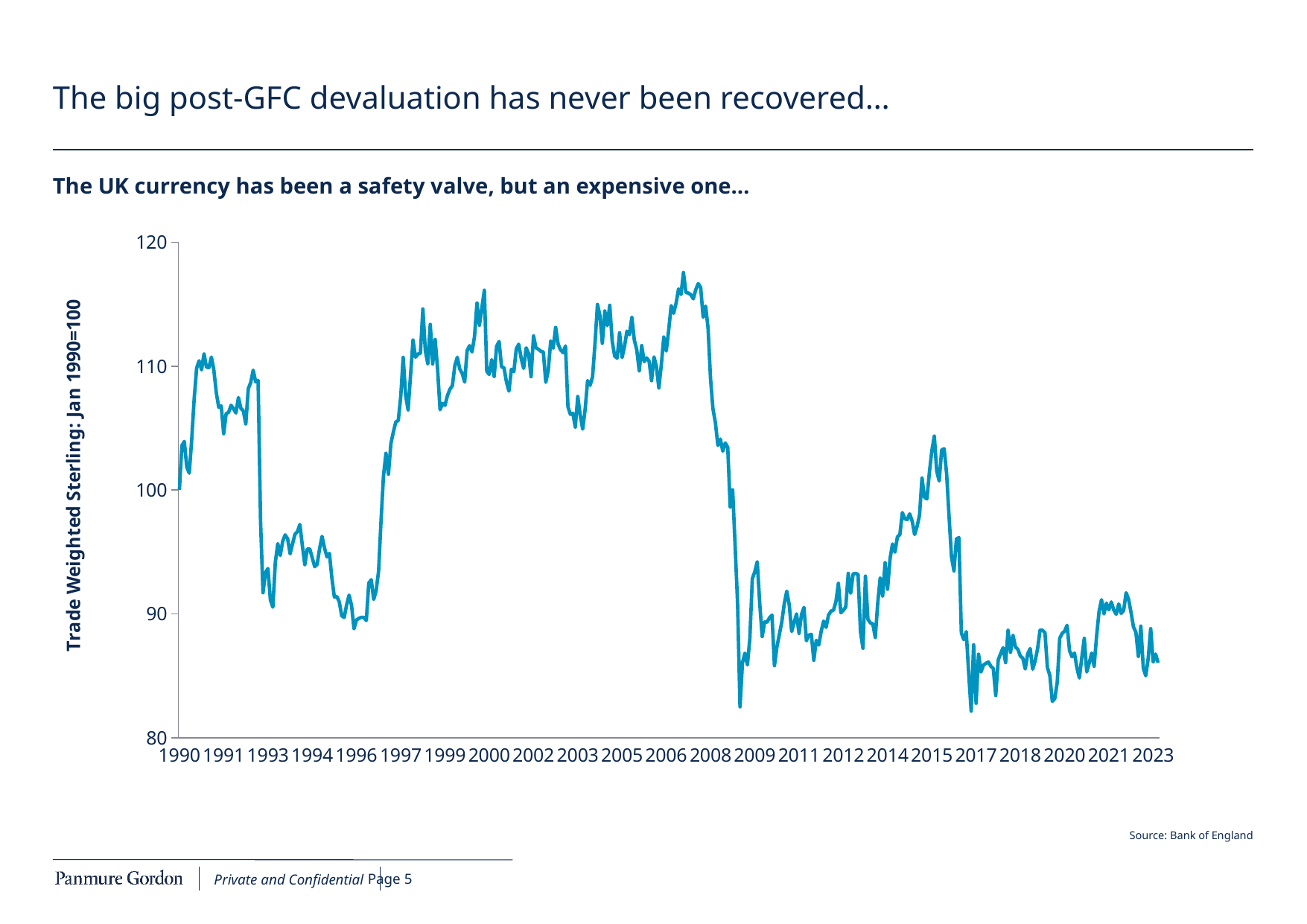
Overall, is Trade Weighted Sterling higher or lower in 2023 than in 1990? lower Does Trade Weighted Sterling rise or fall between 2008 and 2009? fall Does Trade Weighted Sterling rise or fall between 1996 and 1997? rise Is the value of Trade Weighted Sterling in 2000 greater or less than 100? greater Is the value of Trade Weighted Sterling in 2009 greater or less than 90? less What is the source cited for the chart? Bank of England What kind of chart is shown on the slide? line chart How many year labels are shown on the horizontal axis? 23 What is the value of Trade Weighted Sterling in January 1990? 100 Is the value of Trade Weighted Sterling at the end of the series in 2023 greater or less than 90? less What is the label on the vertical axis of the chart? Trade Weighted Sterling: Jan 1990=100